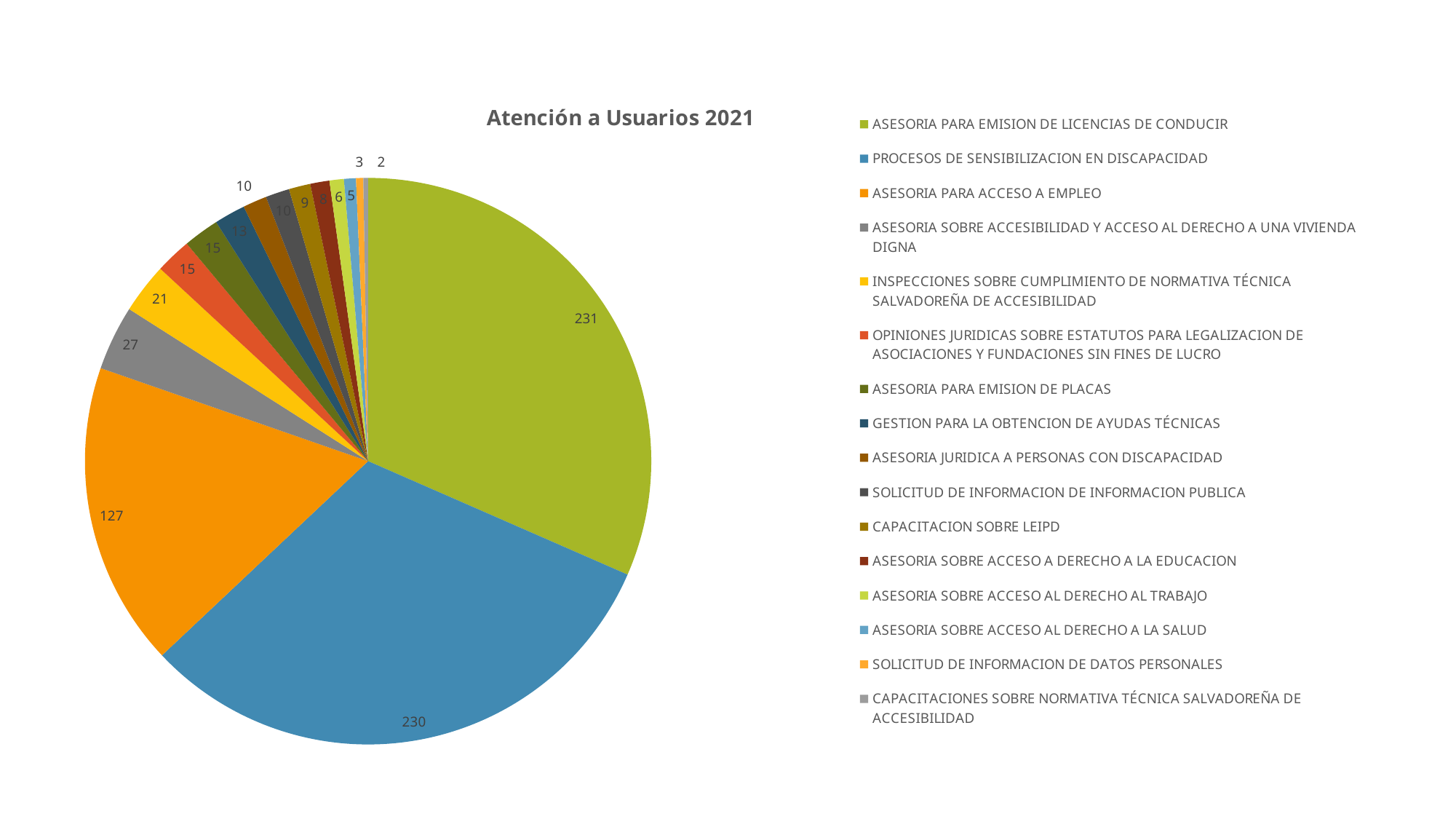
What is the value for ASESORIA PARA ACCESO A EMPLEO? 127 What type of chart is shown on the slide? pie chart What is the difference between the values for ASESORIA PARA EMISION DE LICENCIAS DE CONDUCIR and ASESORIA PARA ACCESO A EMPLEO? 104 What is the value for ASESORIA SOBRE ACCESIBILIDAD Y ACCESO AL DERECHO A UNA VIVIENDA DIGNA? 27 What is the value for ASESORIA PARA EMISION DE LICENCIAS DE CONDUCIR? 231 Which category has the largest slice? ASESORIA PARA EMISION DE LICENCIAS DE CONDUCIR How many categories does the legend list? 16 Which is larger, the value for ASESORIA PARA ACCESO A EMPLEO or the value for ASESORIA SOBRE ACCESIBILIDAD Y ACCESO AL DERECHO A UNA VIVIENDA DIGNA? ASESORIA PARA ACCESO A EMPLEO What is the value for INSPECCIONES SOBRE CUMPLIMIENTO DE NORMATIVA TÉCNICA SALVADOREÑA DE ACCESIBILIDAD? 21 What is the value for PROCESOS DE SENSIBILIZACION EN DISCAPACIDAD? 230 Which category has the smallest slice? CAPACITACIONES SOBRE NORMATIVA TÉCNICA SALVADOREÑA DE ACCESIBILIDAD What is the title of the chart? Atención a Usuarios 2021